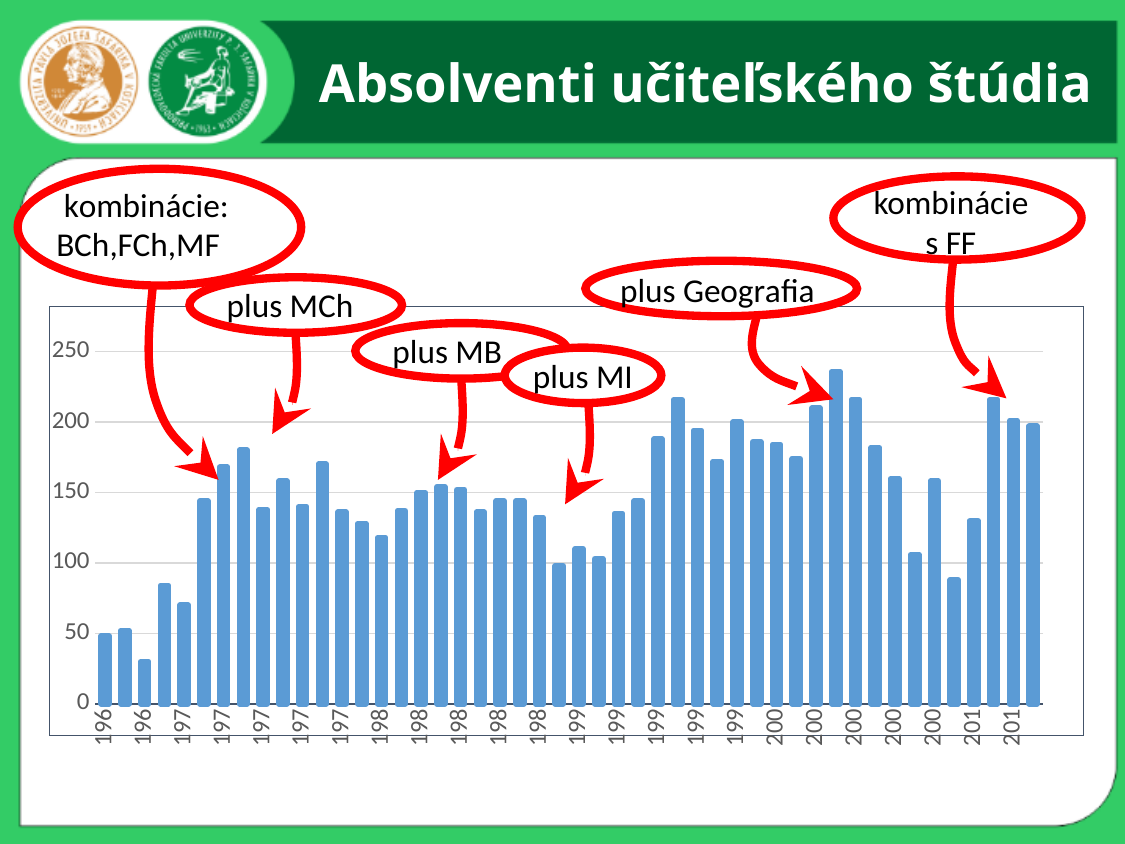
How many data series are plotted in the chart? 1 Is the value of the shortest bar in the chart greater or less than 50? less Is the value of the first (leftmost) bar greater or less than 100? less Is the value of the last (rightmost) bar greater or less than 150? greater What kind of chart is shown on the slide? bar chart What is the title of the slide containing the chart? Absolventi učiteľského štúdia Which is larger, the first bar or the last bar in the chart? the last bar Do the values generally rise or fall from the first bar to the last bar of the chart? rise What is the highest value shown on the chart's vertical axis? 250